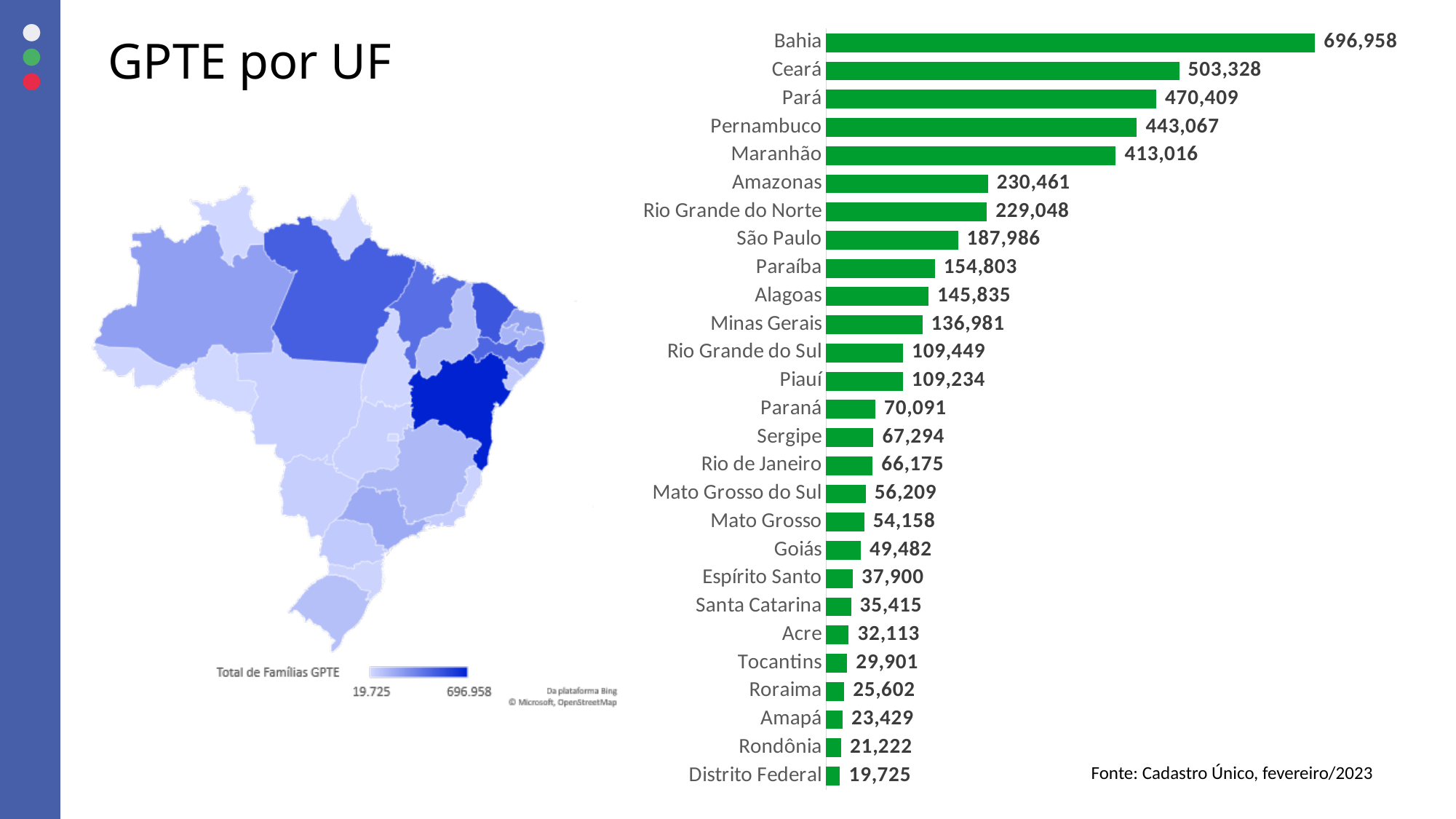
What kind of chart is shown on the right side of the slide? Bar chart In the bar chart on the right, what is the difference between the values for Ceará and Pará? 32,919 How many states are shown in the bar chart on the right? 27 What is the title of the slide containing the bar chart? GPTE por UF In the bar chart on the right, which is larger, the value for São Paulo or the value for Minas Gerais? São Paulo In the bar chart on the right, which category has the lowest value? Distrito Federal In the bar chart on the right, what is the value for Pernambuco? 443,067 In the bar chart on the right, which is larger, the value for Goiás or the value for Mato Grosso? Mato Grosso In the bar chart on the right, what is the value for Bahia? 696,958 In the bar chart on the right, which state has the highest value? Bahia In the bar chart on the right, what is the difference between the values for Bahia and Distrito Federal? 677,233 In the bar chart on the right, what is the value for Rio de Janeiro? 66,175